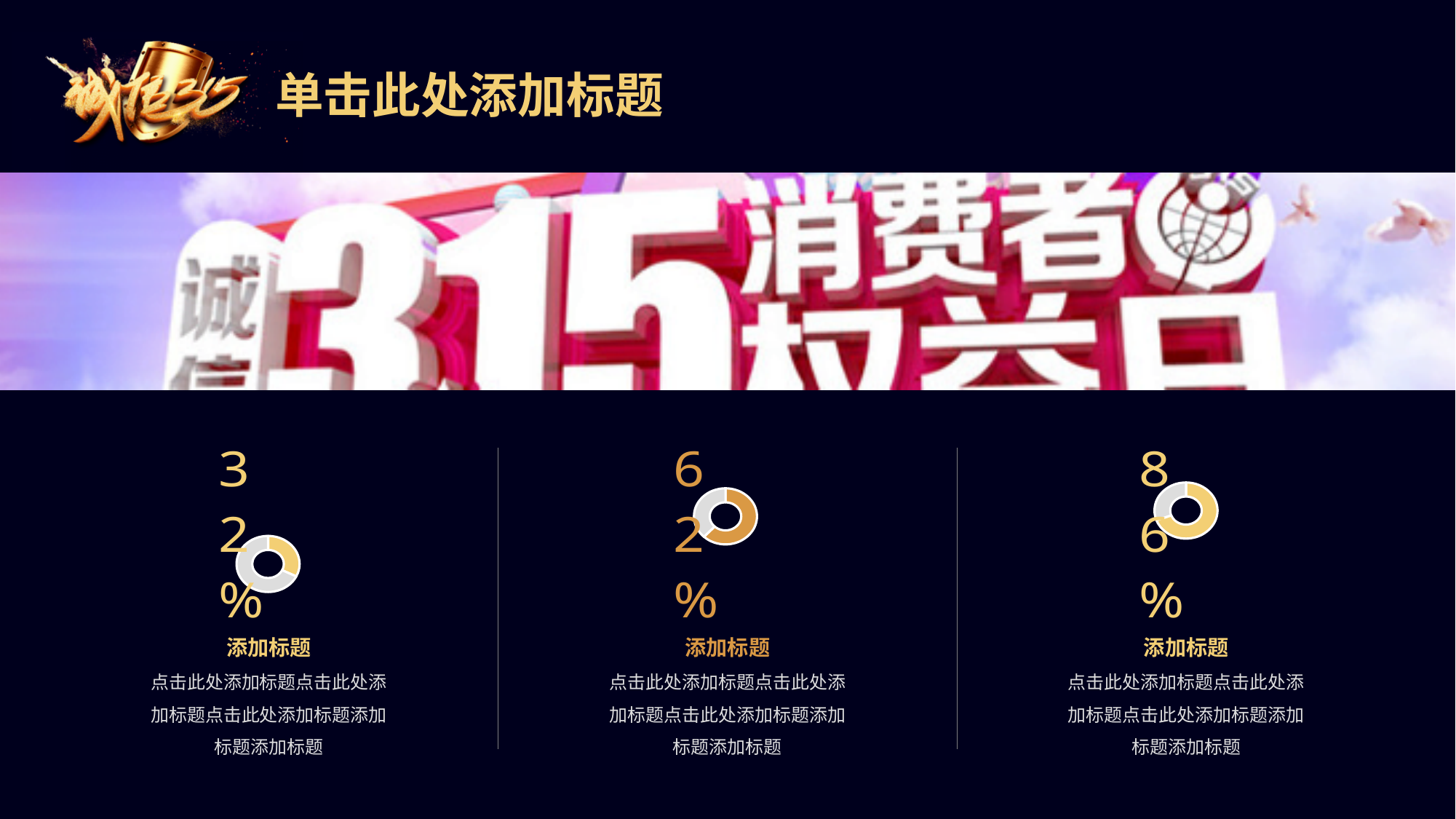
What colour is the filled portion of the middle donut chart? Orange Which of the three donut charts shows the lowest percentage? The left one (32%) Which of the three donut charts shows the highest percentage? The right one (86%) What percentage is printed next to the left donut chart? 32% How many donut charts are on the slide? 3 Is the percentage shown for the left donut chart greater or less than 50%? less What is the difference between the percentage of the middle donut chart and the percentage of the left donut chart? 30% What is the difference between the percentage of the right donut chart and the percentage of the middle donut chart? 24% What percentage is printed next to the right donut chart? 86% What kind of chart is shown in the left panel of the slide? Donut chart Is the percentage for the middle donut chart larger or smaller than the percentage for the left donut chart? Larger What percentage is printed next to the middle donut chart? 62%